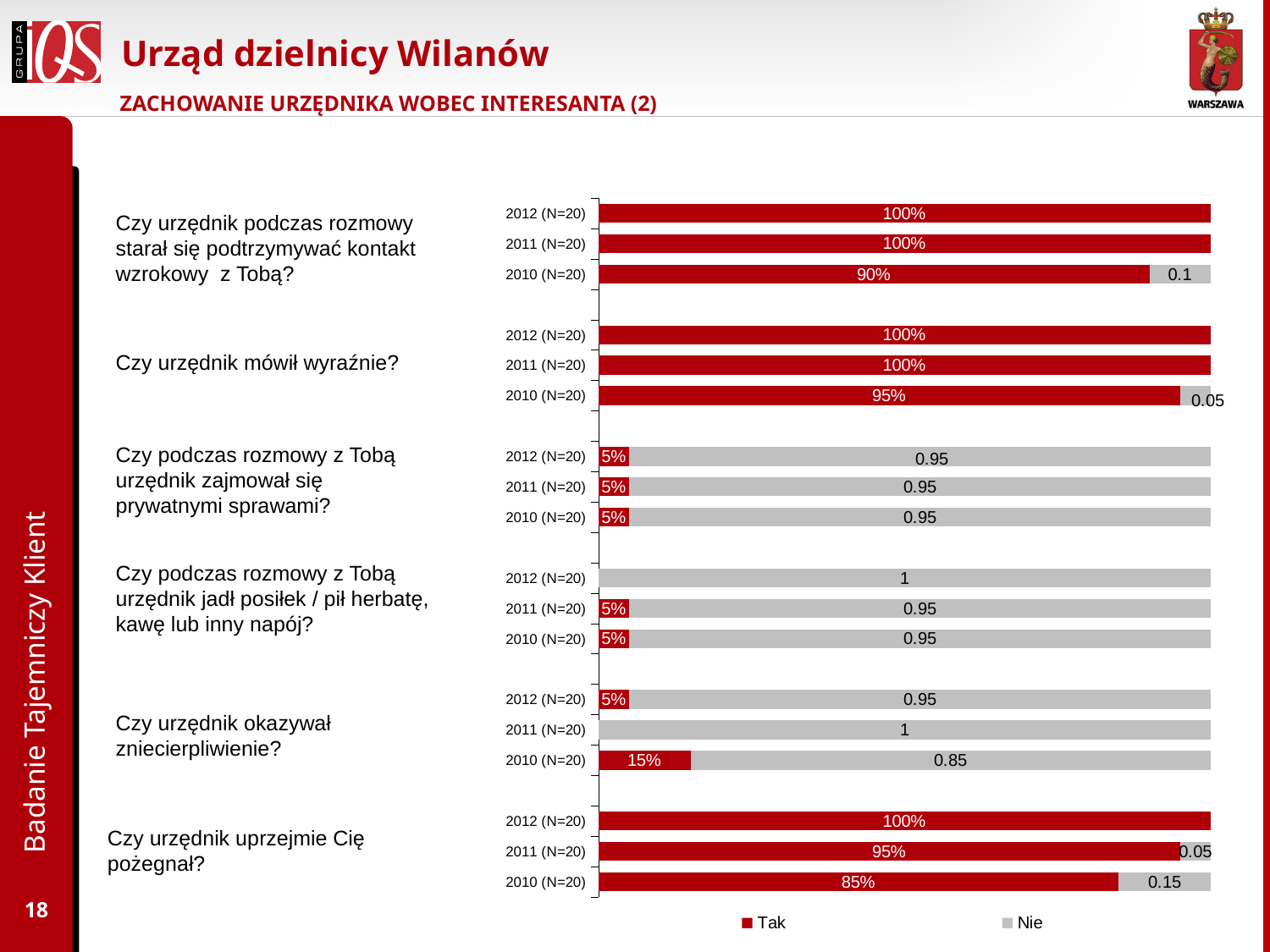
What kind of chart is shown on the slide? bar chart For the question "Czy urzędnik uprzejmie Cię pożegnał?", does the Tak value rise or fall from 2010 to 2012? rises What are the two legend entries of the chart? Tak and Nie For the question "Czy urzędnik uprzejmie Cię pożegnał?", what is the difference between the Tak value for 2012 (N=20) and for 2010 (N=20)? 15 percentage points For the question "Czy urzędnik uprzejmie Cię pożegnał?", what is the Nie value for 2010 (N=20)? 0.15 For the question "Czy urzędnik podczas rozmowy starał się podtrzymywać kontakt wzrokowy z Tobą?", what is the Nie value for 2010 (N=20)? 0.1 For the question "Czy urzędnik podczas rozmowy starał się podtrzymywać kontakt wzrokowy z Tobą?", what is the Tak value for 2010 (N=20)? 90% For the question "Czy urzędnik mówił wyraźnie?", what is the Tak value for 2010 (N=20)? 95% For the question "Czy urzędnik okazywał zniecierpliwienie?", what is the Nie value for 2011 (N=20)? 1 For the question "Czy urzędnik okazywał zniecierpliwienie?", what is the Tak value for 2010 (N=20)? 15% How many series does the legend list? 2 For the question "Czy urzędnik uprzejmie Cię pożegnał?", which year has the higher Tak value, 2012 or 2010? 2012